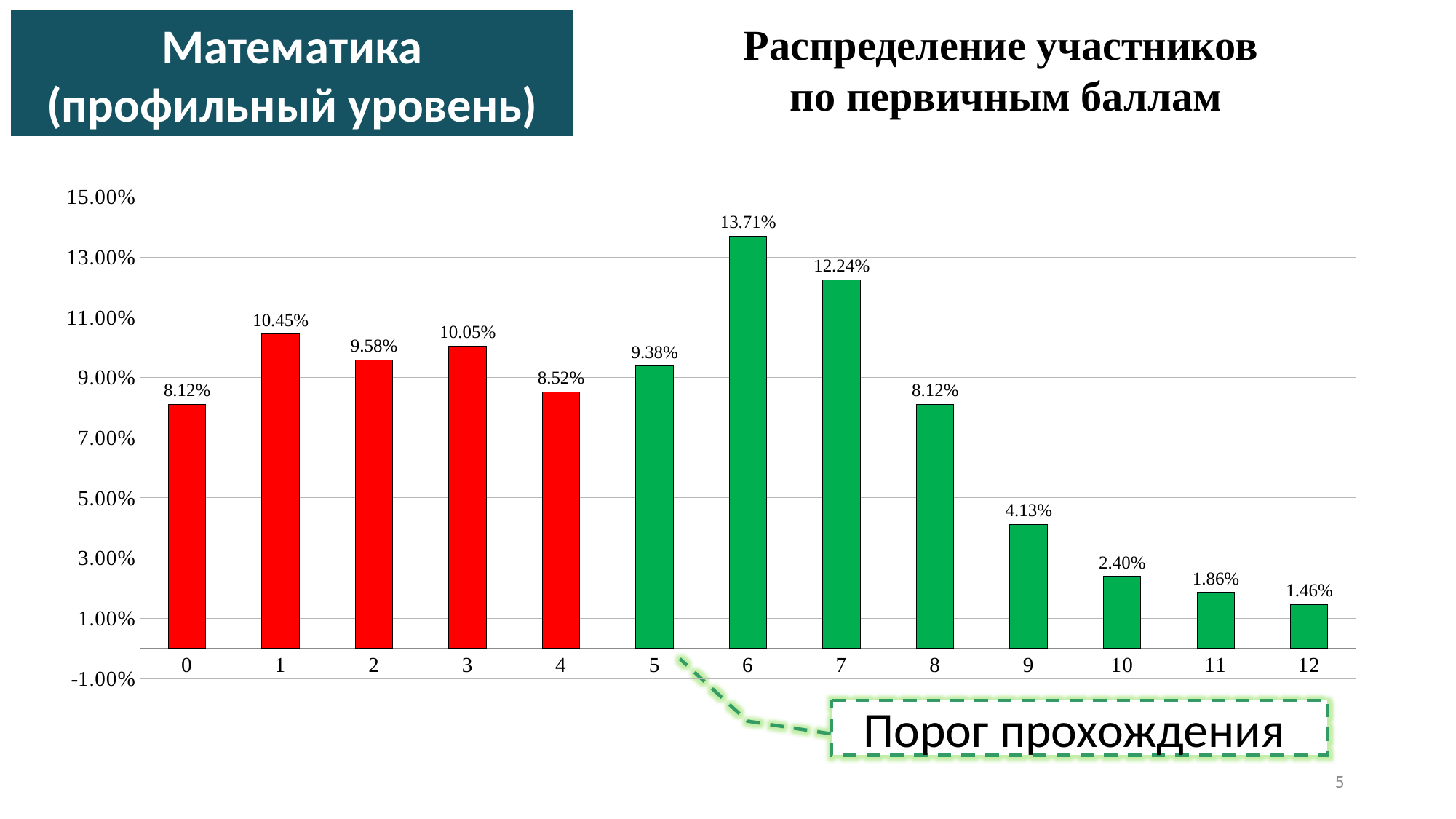
What does the dashed callout box below the chart say? Порог прохождения What is the value for primary score 6? 13.71% Do the values rise or fall from primary score 7 to primary score 12? fall What is the value for primary score 12? 1.46% What kind of chart is shown on the slide? bar chart What is the value for primary score 1? 10.45% What is the difference between the values for primary scores 6 and 7? 1.47% Which primary score has the lowest share of participants? 12 Is the value for primary score 9 greater or less than 5.00%? less Which is larger: the value for primary score 2 or primary score 3? 3 Which primary score has the highest share of participants? 6 How many primary score categories are shown on the x axis? 13